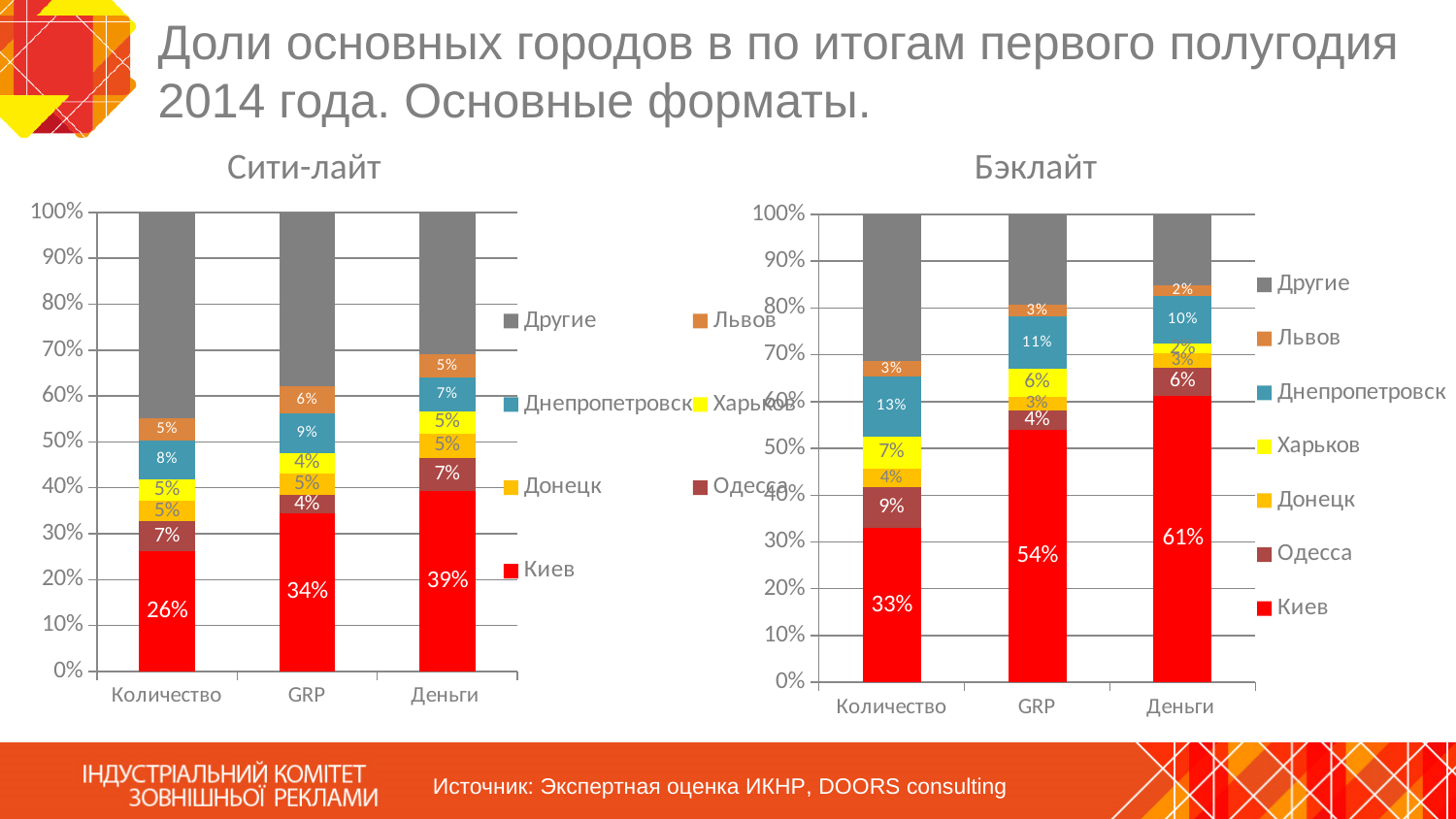
What kind of chart is the Бэклайт chart? stacked bar chart In the Бэклайт chart, which category has the highest value for Киев? Деньги In the Сити-лайт chart, what is the value for Киев in the Количество bar? 26% In the Сити-лайт chart, what is the value for Днепропетровск in the GRP bar? 9% How many categories are shown on the x axis of the Сити-лайт chart? 3 How many series does the legend of the Бэклайт chart list? 7 In the Бэклайт chart, what is the value for Днепропетровск in the Количество bar? 13% In the Сити-лайт chart, which is larger: the Киев value for GRP or for Деньги? Деньги In the Бэклайт chart, what is the difference between the Киев values for Деньги and Количество? 28% In the Бэклайт chart, do the Киев values rise or fall from Количество to Деньги? rise In the Сити-лайт chart, which category has the lowest value for Киев? Количество In the Бэклайт chart, what is the value for Киев in the Деньги bar? 61%